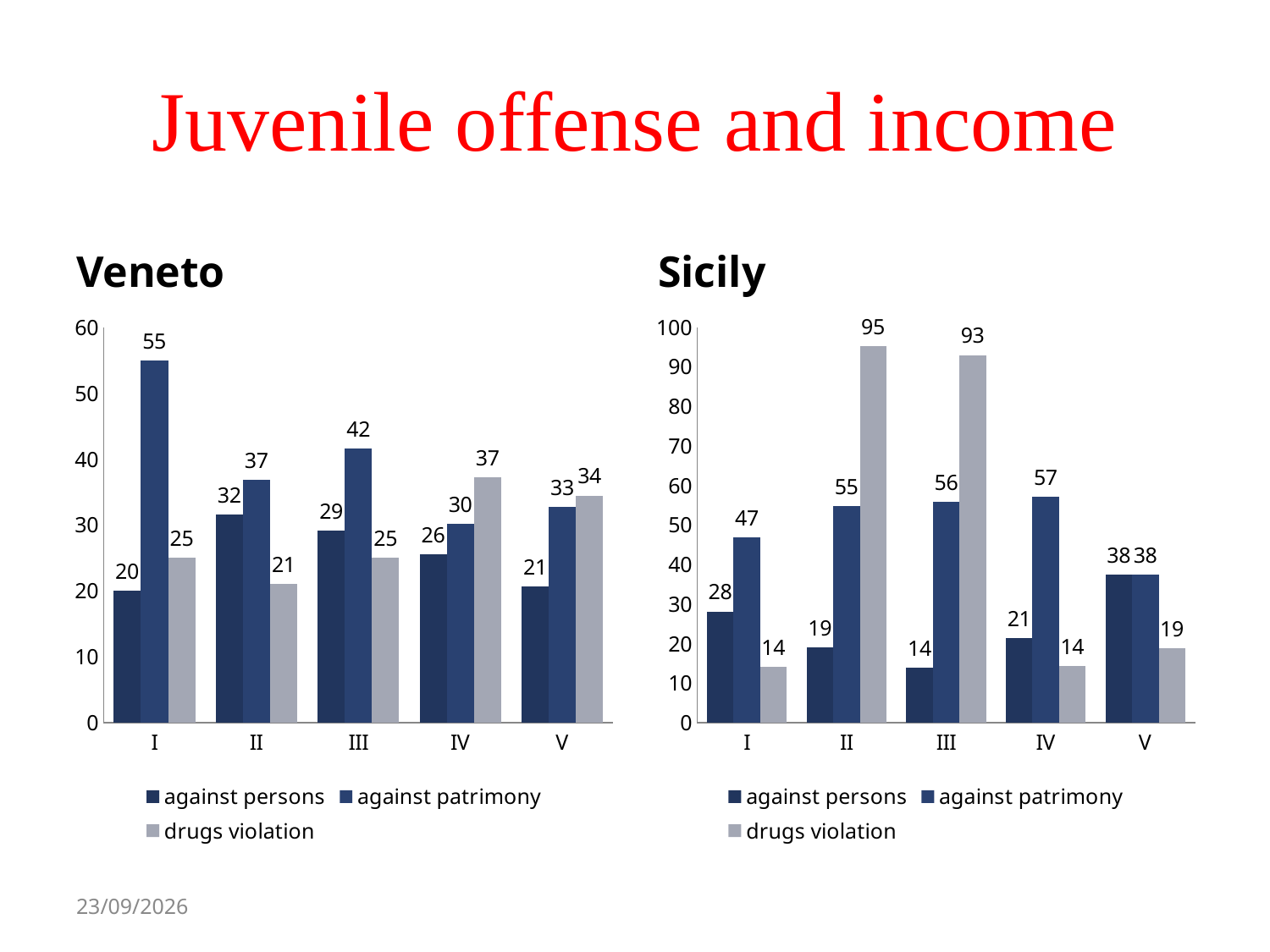
In the Veneto chart, what is the value for against patrimony in category I? 55 What kind of chart is the Veneto chart? bar chart How many categories are shown on the x axis of the Veneto chart? 5 In the Veneto chart, what is the value for drugs violation in category IV? 37 In the Sicily chart, which is larger in category IV: against patrimony or drugs violation? against patrimony In the Sicily chart, does the value for against patrimony rise or fall from category I to category IV? rise In the Sicily chart, what is the value for drugs violation in category II? 95 In the Sicily chart, which category has the highest value for against persons? V How many series does the legend of the Sicily chart list? 3 In the Veneto chart, which category has the lowest value for against persons? I In the Sicily chart, what is the difference between drugs violation in category II and in category III? 2 In the Veneto chart, what is the difference between against patrimony and against persons in category I? 35